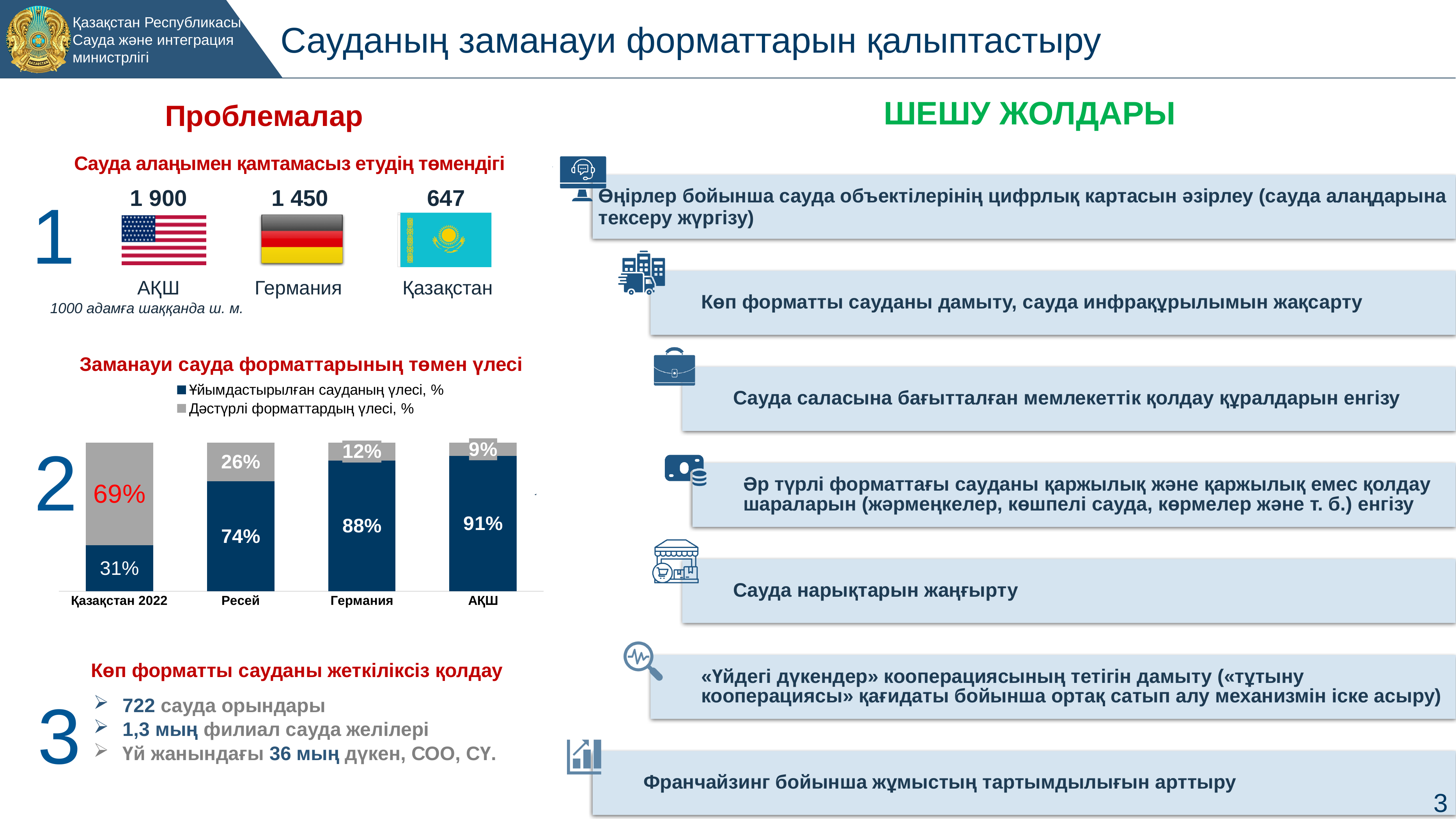
In the stacked bar chart, what is the value of "Ұйымдастырылған сауданың үлесі, %" for Қазақстан 2022? 31% How many categories are shown on the x axis of the stacked bar chart? 4 In the stacked bar chart, what is the value of "Ұйымдастырылған сауданың үлесі, %" for Германия? 88% In the stacked bar chart, which category has the highest value for "Ұйымдастырылған сауданың үлесі, %"? АҚШ How many series does the legend of the stacked bar chart list? 2 In the stacked bar chart, does "Ұйымдастырылған сауданың үлесі, %" rise or fall from Қазақстан 2022 to АҚШ along the x axis? Rise In the stacked bar chart, which category has the lowest value for "Ұйымдастырылған сауданың үлесі, %"? Қазақстан 2022 In the stacked bar chart, what is the value of "Дәстүрлі форматтардың үлесі, %" for АҚШ? 9% In the stacked bar chart, what is the difference between the "Ұйымдастырылған сауданың үлесі, %" values for АҚШ and Қазақстан 2022? 60% In the stacked bar chart, which is larger: "Дәстүрлі форматтардың үлесі, %" for Ресей or for Германия? Ресей In the stacked bar chart, what is the value of "Дәстүрлі форматтардың үлесі, %" for Ресей? 26% What kind of chart is shown under the heading "Заманауи сауда форматтарының төмен үлесі"? Stacked bar chart